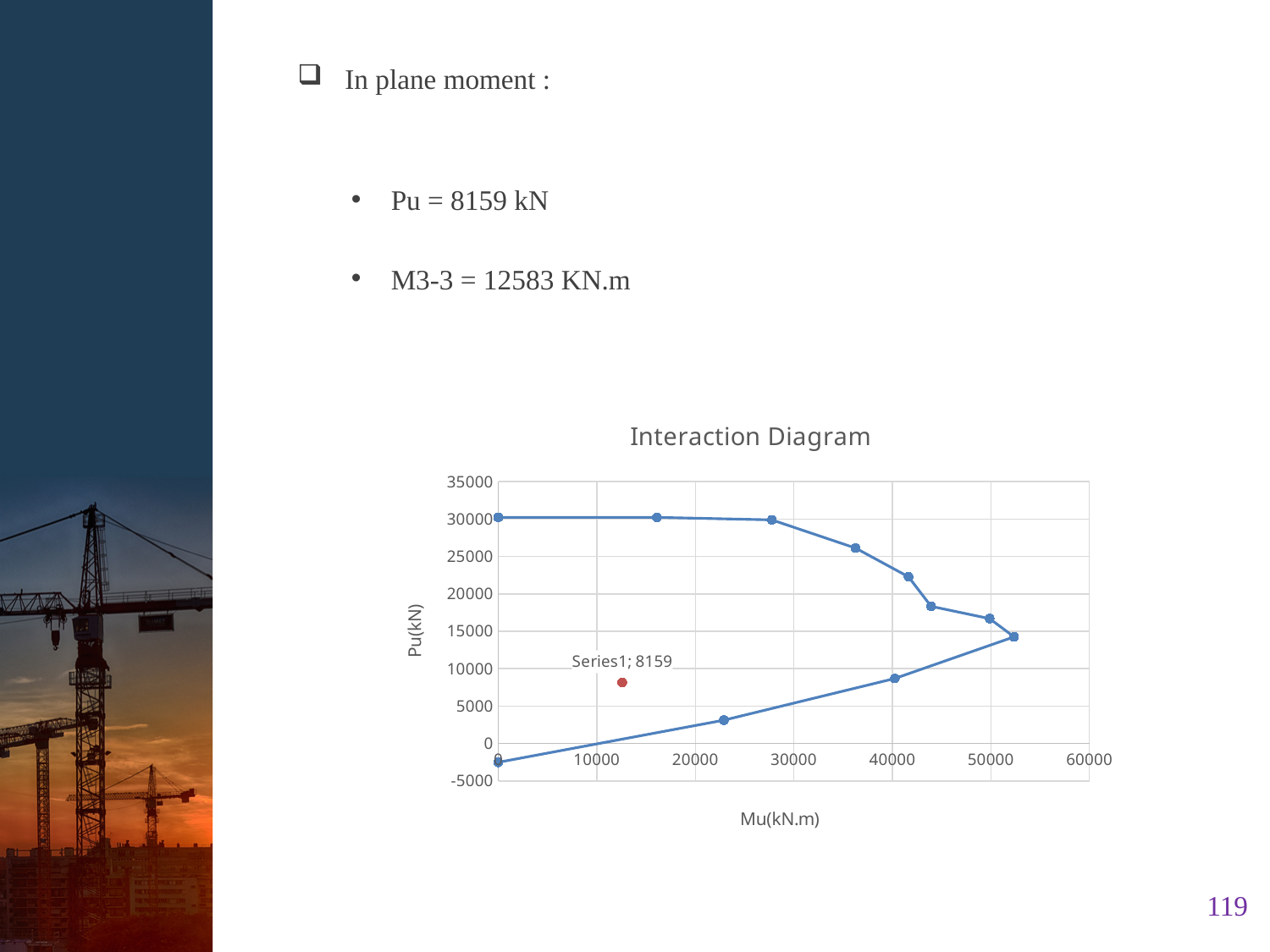
Is the Pu value of the red labeled point greater or less than 10000? less Is the lowest Pu value on the blue curve greater or less than 0? less What kind of chart is shown on the slide? scatter chart Is the Mu value of the red labeled point greater or less than 10000? greater What series name is printed in the data label on the red point? Series1 How many points are plotted on the blue curve? 11 What is the title of the chart? Interaction Diagram What is the maximum value shown on the vertical axis? 35000 What is the label of the horizontal axis of the chart? Mu(kN.m) What Pu value is printed in the data label on the red point? 8159